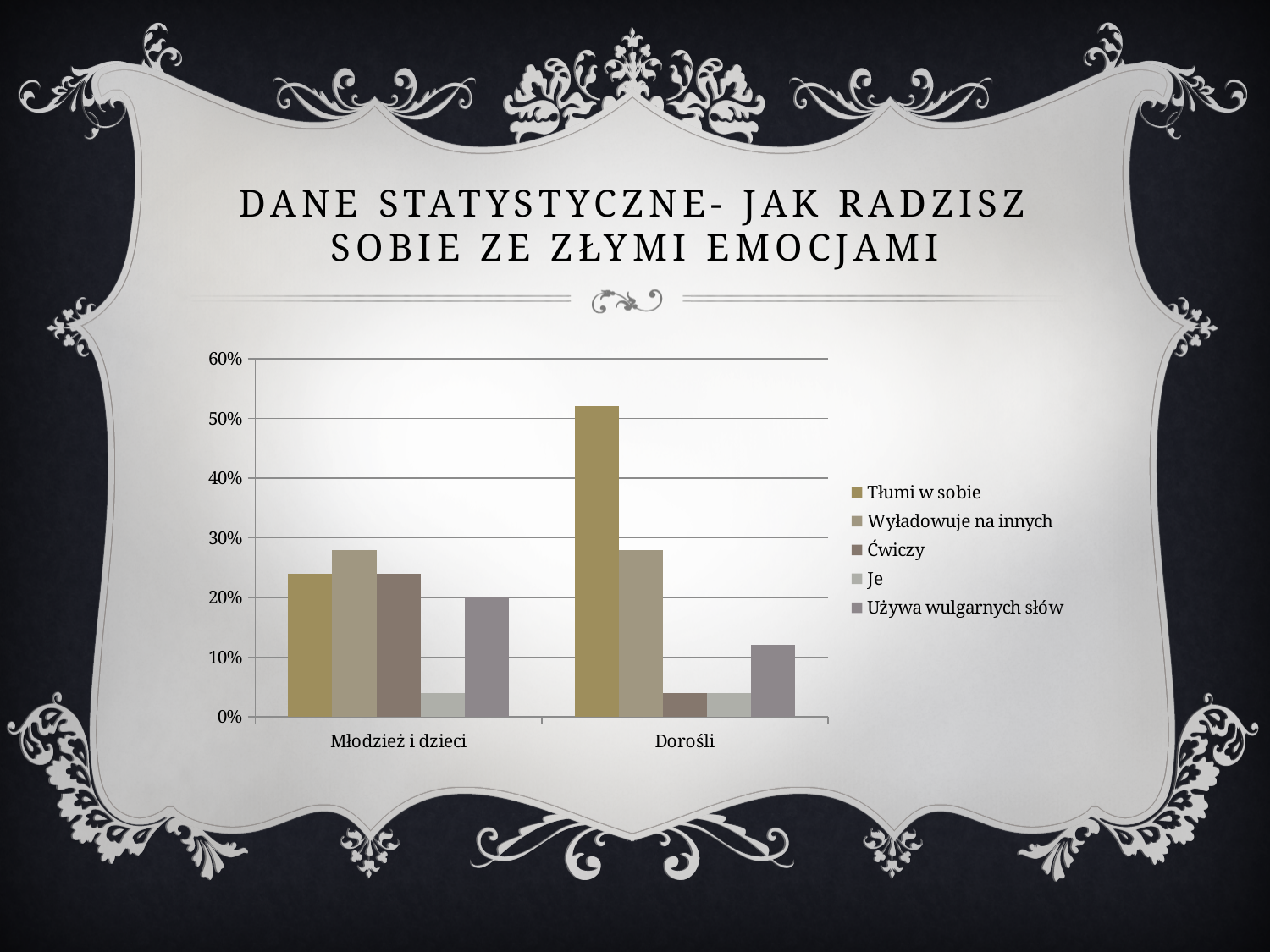
Which series has the highest value for Młodzież i dzieci? Wyładowuje na innych How many series does the legend list? 5 Is the value of Tłumi w sobie for Dorośli greater or less than 50%? greater Is the value of Używa wulgarnych słów for Dorośli greater or less than 10%? greater What kind of chart is shown on the slide? bar chart Which series has the lowest value for Młodzież i dzieci? Je Which series has the highest value for Dorośli? Tłumi w sobie Is the value of Ćwiczy for Dorośli greater or less than 10%? less How many categories are shown on the x axis? 2 Which is larger: Używa wulgarnych słów for Młodzież i dzieci or for Dorośli? Młodzież i dzieci What is the title of the slide containing the chart? Dane statystyczne- jak radzisz sobie ze złymi emocjami Which is larger: Tłumi w sobie for Dorośli or Tłumi w sobie for Młodzież i dzieci? Dorośli